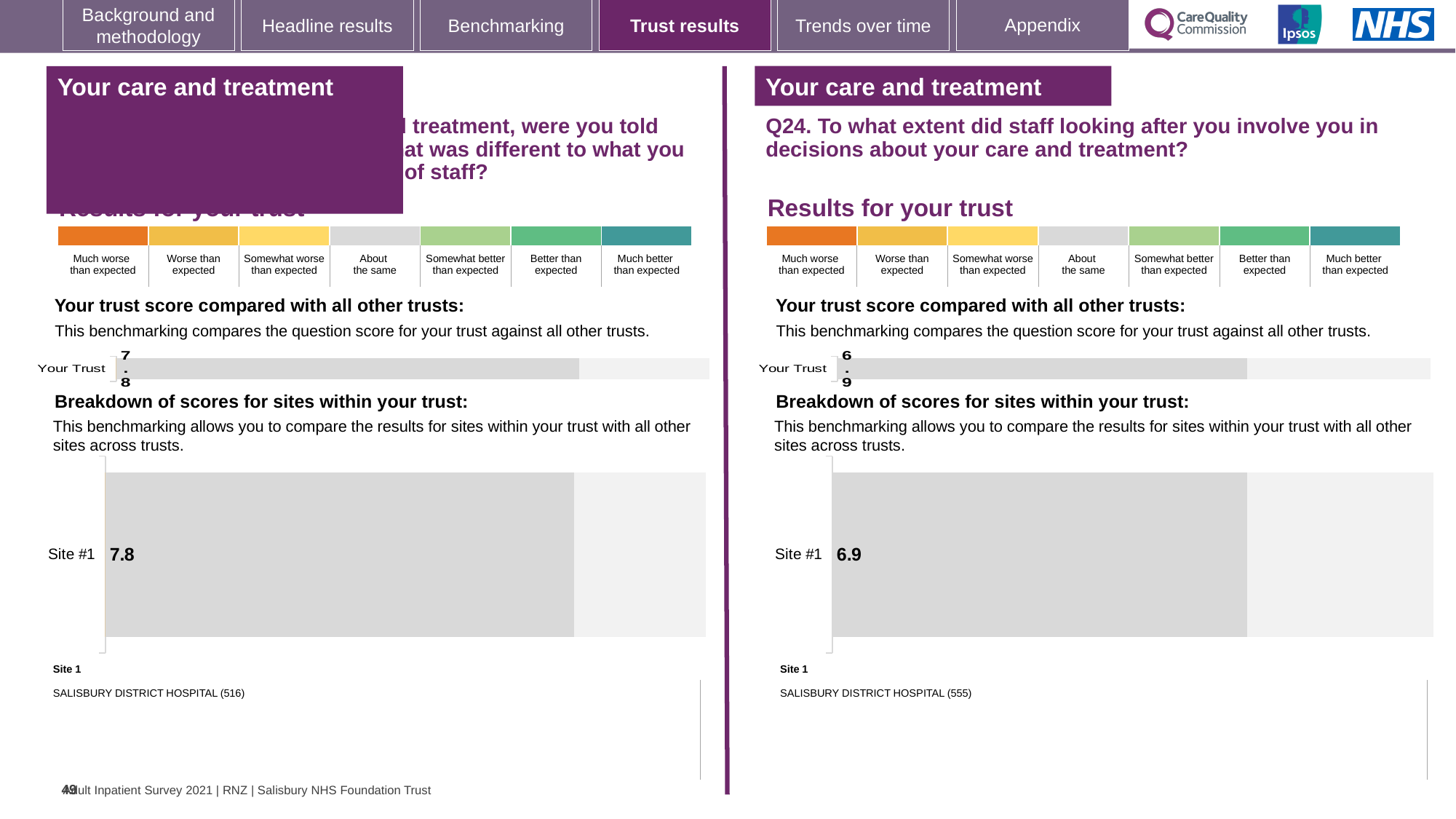
Which is larger: the Site #1 score in the left-hand chart or the Site #1 score in the right-hand chart? Left-hand chart How many sites are shown in the left-hand site breakdown chart? 1 What is the name of Site 1 listed under the right-hand site breakdown chart? SALISBURY DISTRICT HOSPITAL (555) How many sites are shown in the right-hand site breakdown chart? 1 What is the difference between the Site #1 score in the left-hand chart and the Site #1 score in the right-hand chart? 0.9 In the right-hand site breakdown chart (Q24), what is the score for Site #1? 6.9 What kind of chart is used for the site breakdown on the right half of the slide? Bar chart On the right half of the slide (Q24), what is the score shown for Your Trust? 6.9 Is the Your Trust score on the right half of the slide greater or less than the Your Trust score on the left half? less What is the name of Site 1 listed under the left-hand site breakdown chart? SALISBURY DISTRICT HOSPITAL (516) In the left-hand site breakdown chart, what is the score for Site #1? 7.8 On the left half of the slide, what is the score shown for Your Trust? 7.8